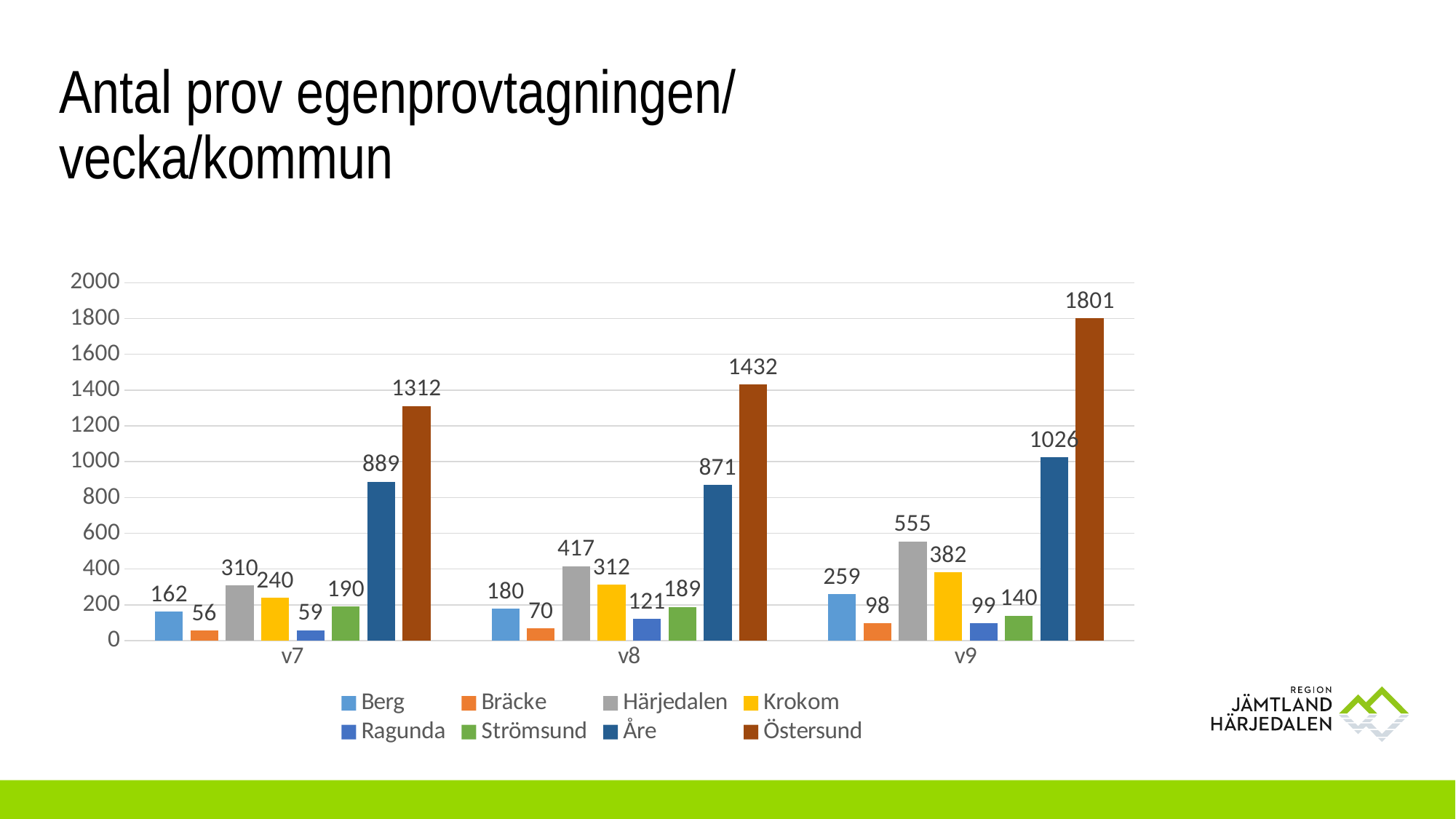
What kind of chart is shown on the slide? bar chart How many series does the legend list? 8 What is the value for Östersund in week v9? 1801 Which municipality has the lowest value in week v7? Bräcke What is the value for Härjedalen in week v8? 417 Which municipality has the highest value in week v8? Östersund What is the value for Ragunda in week v7? 59 How many weeks are shown on the x axis? 3 What colour are the bars for Östersund? brown What is the difference between Östersund and Åre in week v9? 775 Do the values for Östersund rise or fall from v7 to v9? rise Which is larger in week v8: Krokom or Härjedalen? Härjedalen